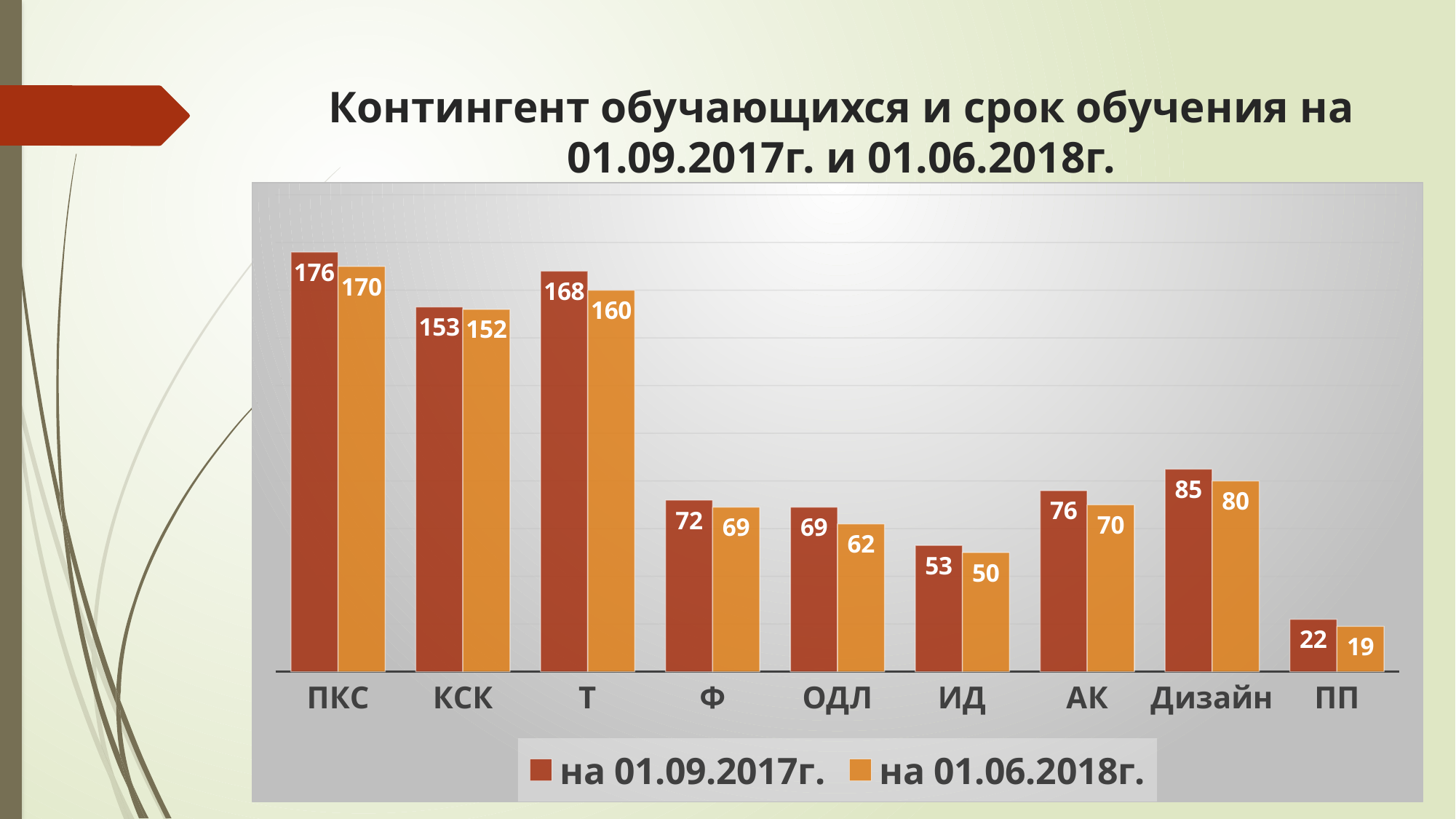
Which is larger in the series 'на 01.06.2018г.': АК or Дизайн? Дизайн What kind of chart is shown on the slide? Bar chart Which category has the highest value in the series 'на 01.06.2018г.'? ПКС Which series is shown in orange according to the legend? на 01.06.2018г. What is the difference between the 'на 01.09.2017г.' values for ПКС and КСК? 23 What is the value for Дизайн in the series 'на 01.09.2017г.'? 85 What is the value for Т in the series 'на 01.06.2018г.'? 160 How many categories are shown on the x axis? 9 What is the value for ПКС in the series 'на 01.09.2017г.'? 176 What is the difference between the 'на 01.09.2017г.' and 'на 01.06.2018г.' values for Т? 8 How many series does the legend list? 2 Which category has the lowest value in the series 'на 01.09.2017г.'? ПП